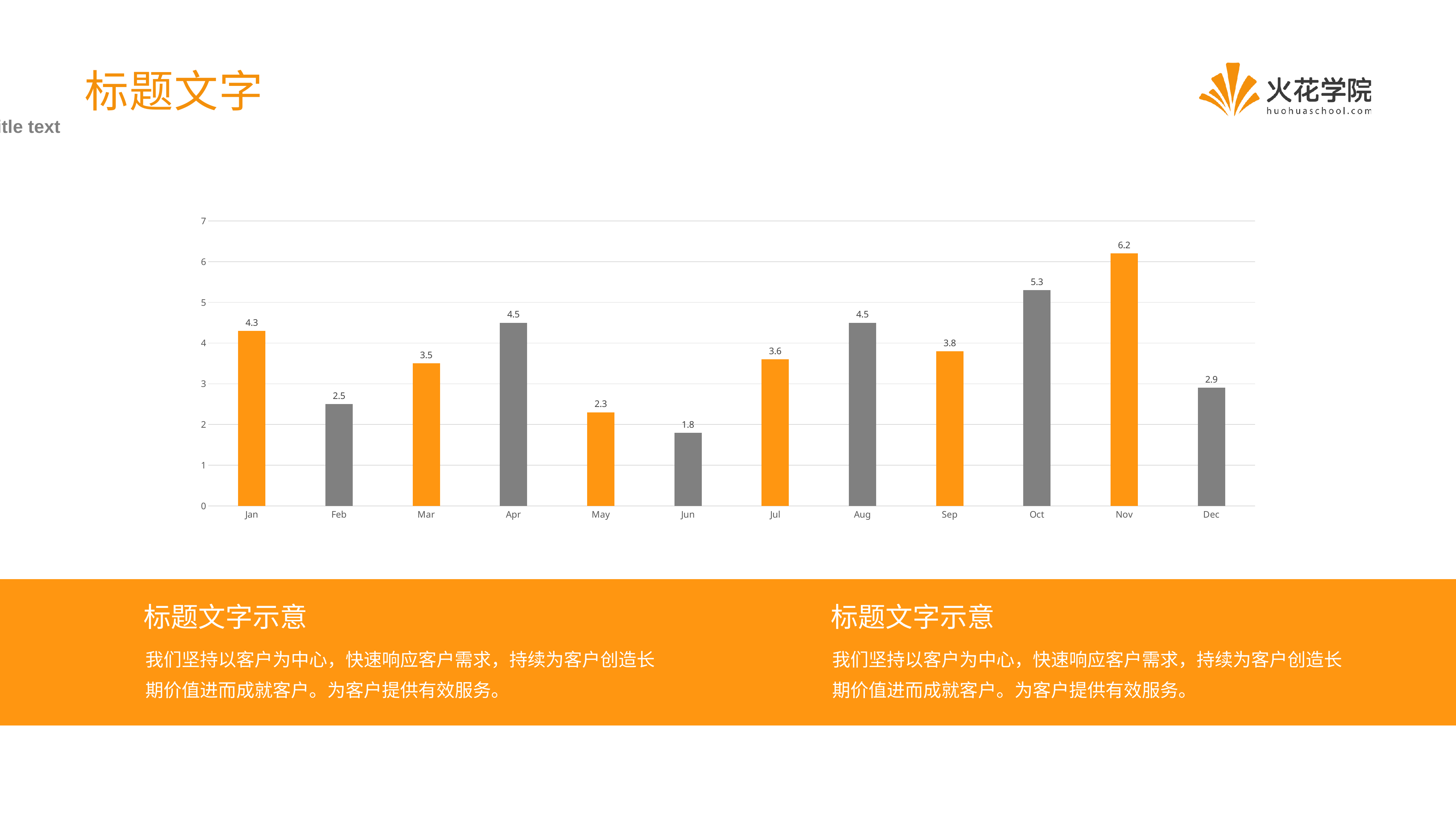
What kind of chart is shown on the slide? bar chart What colour is the bar for Apr? grey Is the value for Feb greater or less than 3? less Which month has the lowest value? Jun Which month has the highest value? Nov What is the value for Oct? 5.3 What is the value for Jun? 1.8 What is the value for Jan? 4.3 What is the difference between the values for Nov and Dec? 3.3 How many months are shown on the x axis? 12 Which is larger, the value for Mar or the value for Sep? Sep Do the values rise or fall from Sep to Nov? rise